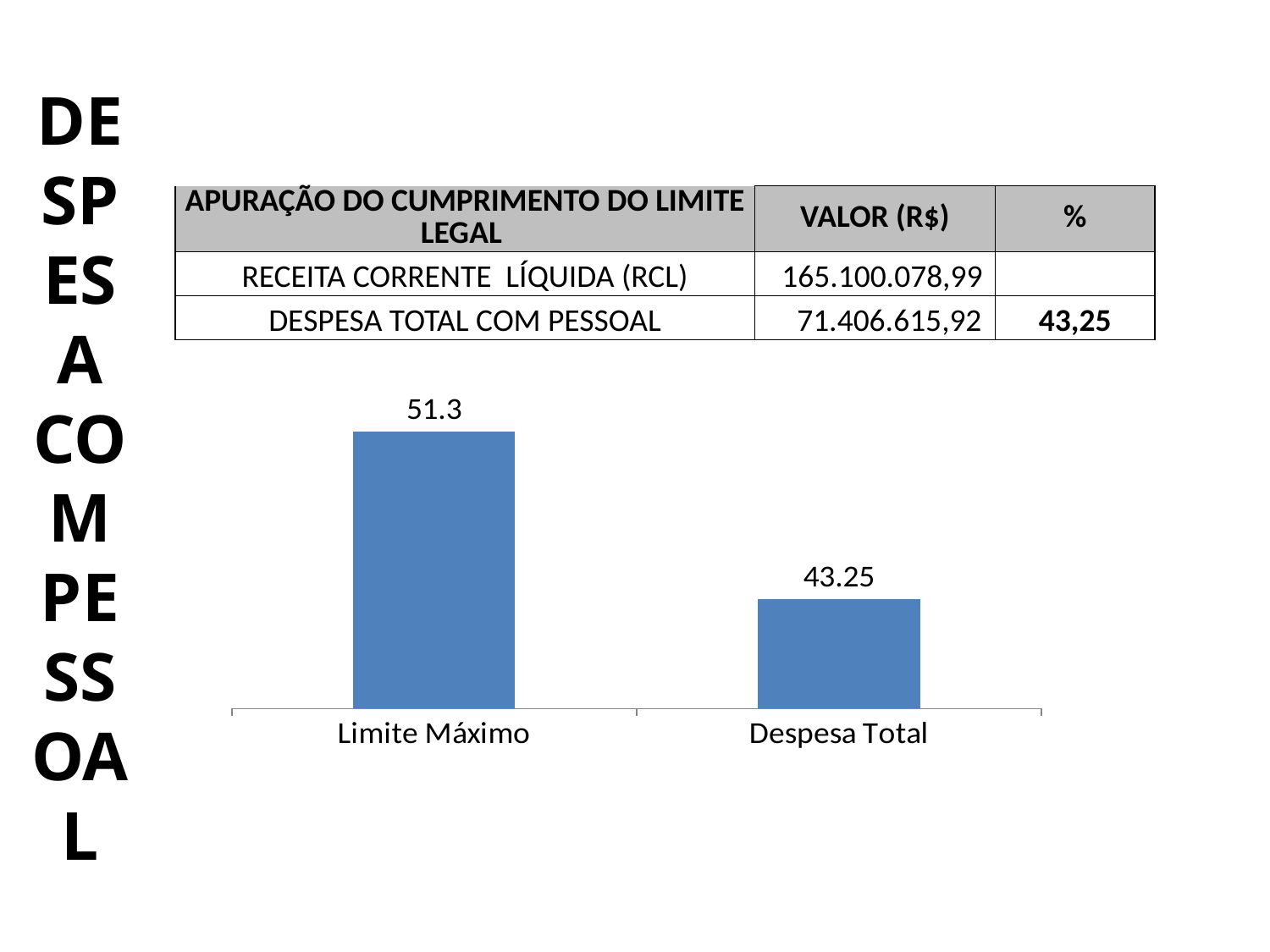
Which category has the highest value? Limite Máximo What is the label of the first category on the x axis? Limite Máximo What is the value for Despesa Total? 43.25 What is the value for Limite Máximo? 51.3 Do the values rise or fall from left to right along the x axis? fall What kind of chart is shown on the slide? bar chart How many categories are shown in the chart? 2 Which is larger, the value for Limite Máximo or the value for Despesa Total? Limite Máximo Which category has the lowest value? Despesa Total What colour are the bars in the chart? blue What is the difference between the values for Limite Máximo and Despesa Total? 8.05